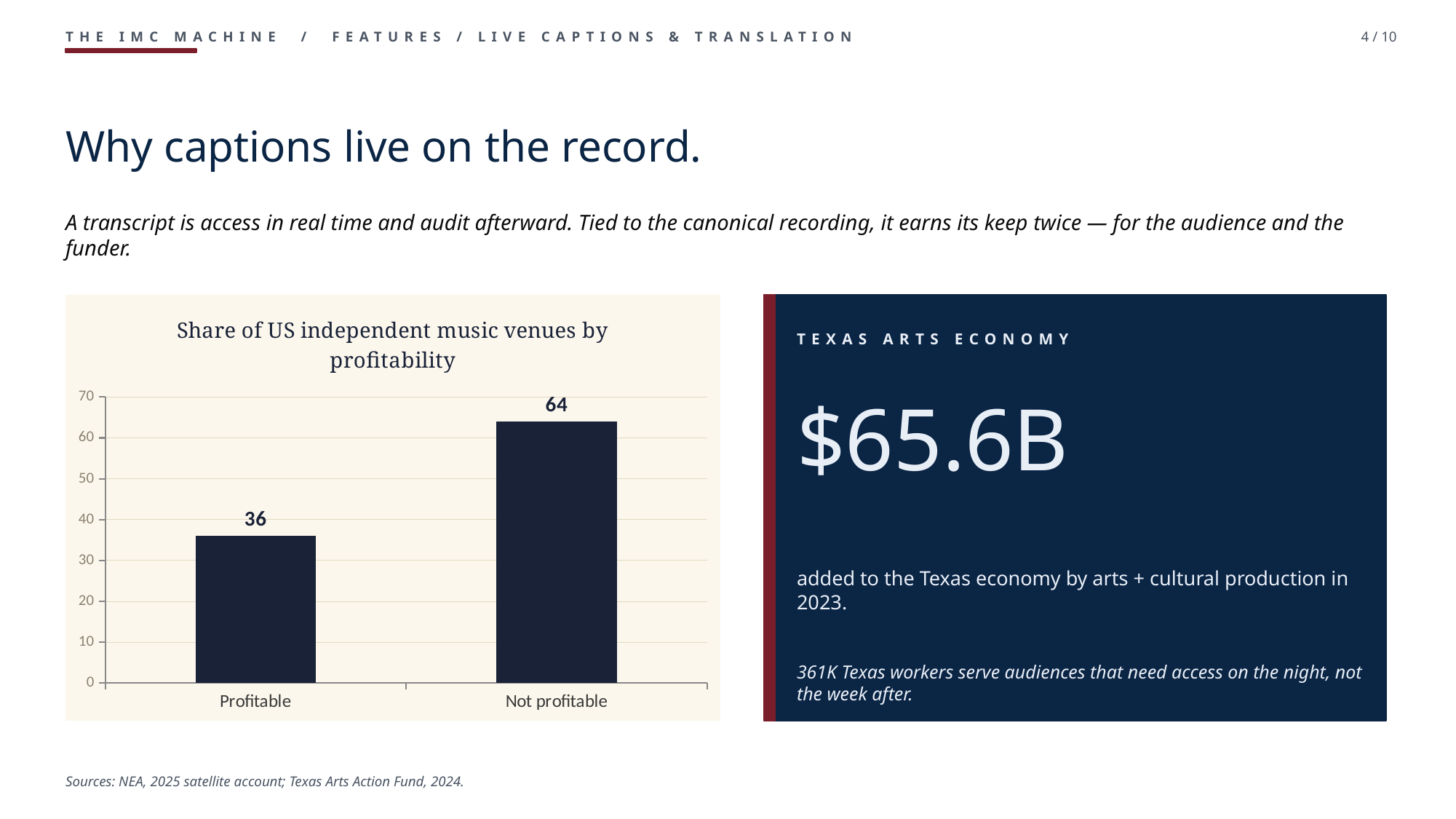
What is the value for Profitable in the chart? 36 What is the value for Not profitable in the chart? 64 What is the title of the chart? Share of US independent music venues by profitability Is the value for Not profitable greater or less than 60? greater Is the value for Profitable greater or less than 40? less What is the difference between the Not profitable and Profitable values? 28 How many categories are shown in the chart? 2 What is the highest value shown on the chart's vertical axis? 70 What kind of chart is shown on the slide? bar chart Which category has the highest value in the chart? Not profitable Which is larger, the value for Profitable or the value for Not profitable? Not profitable Which category has the lowest value in the chart? Profitable